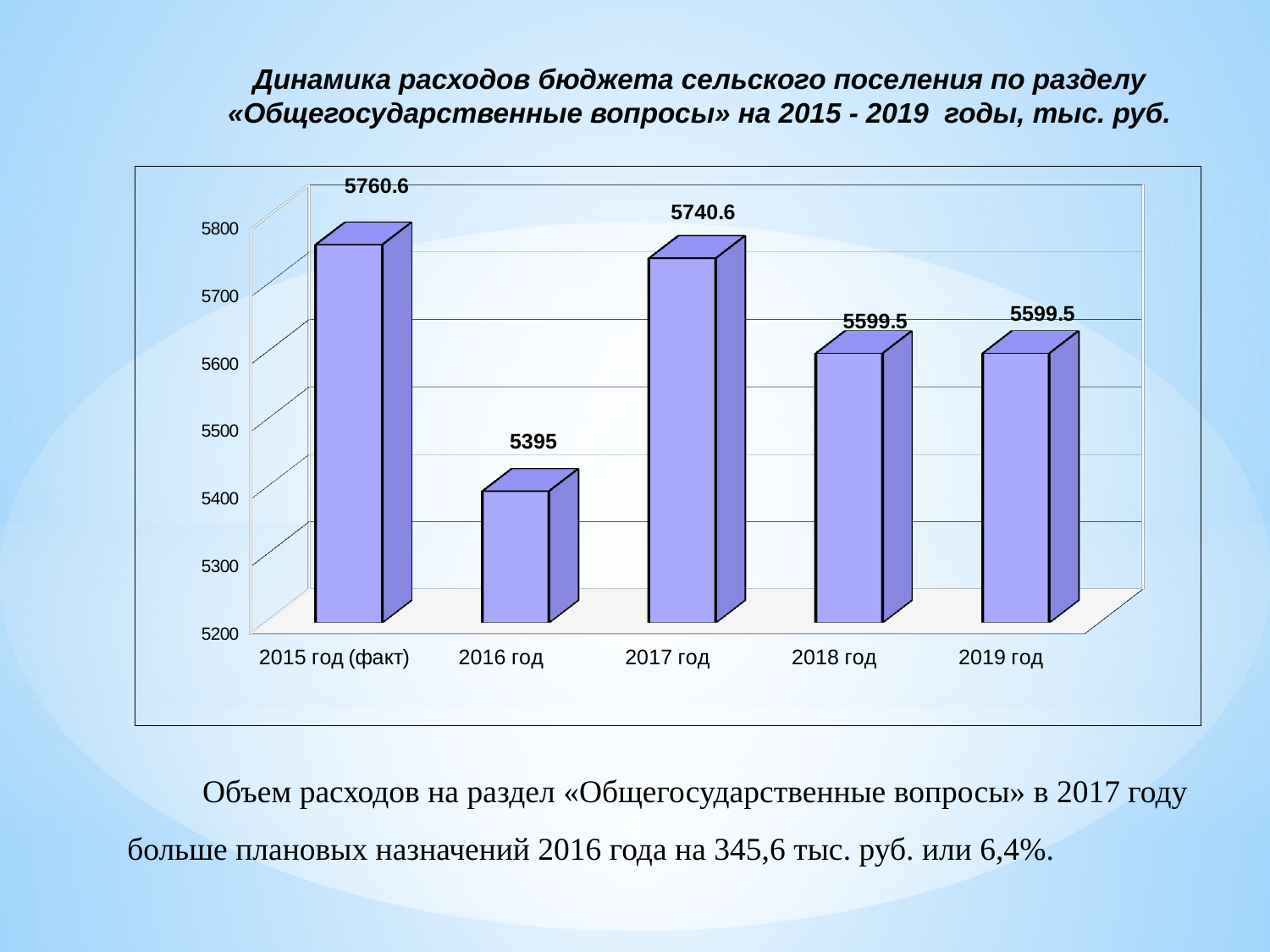
What is the value for 2015 год (факт)? 5760.6 Which category has the lowest value? 2016 год Which is larger, the value for 2017 год or the value for 2018 год? 2017 год Which category has the highest value? 2015 год (факт) What is the difference between the values for 2017 год and 2016 год? 345.6 How many categories are shown on the x axis? 5 What is the value for 2017 год? 5740.6 What kind of chart is shown on the slide? bar chart What is the value for 2016 год? 5395 What is the value for 2019 год? 5599.5 Is the value for 2016 год greater or less than 5400? less What is the difference between the values for 2015 год (факт) and 2017 год? 20